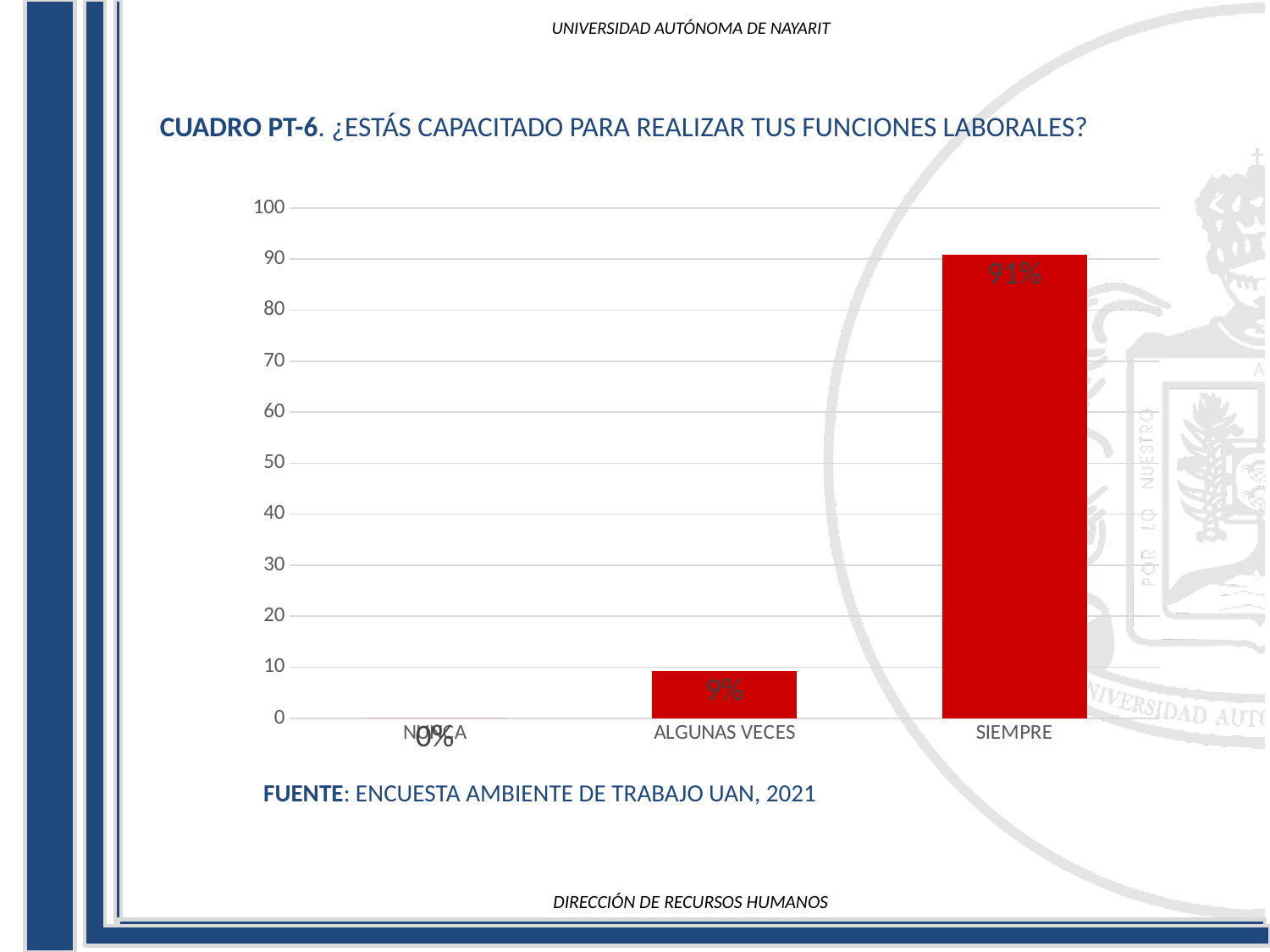
What is the value for ALGUNAS VECES? 9% Which is larger, the value for ALGUNAS VECES or the value for SIEMPRE? SIEMPRE What is the value for NUNCA? 0% What is the difference between the values for SIEMPRE and ALGUNAS VECES? 82% Is the value for ALGUNAS VECES greater or less than 20? less Which category has the highest value? SIEMPRE What kind of chart is shown on the slide? bar chart What is the source cited below the chart? ENCUESTA AMBIENTE DE TRABAJO UAN, 2021 Is the value for SIEMPRE greater or less than 50? greater Which category has the lowest value? NUNCA How many categories are shown on the x axis? 3 What is the value for SIEMPRE? 91%